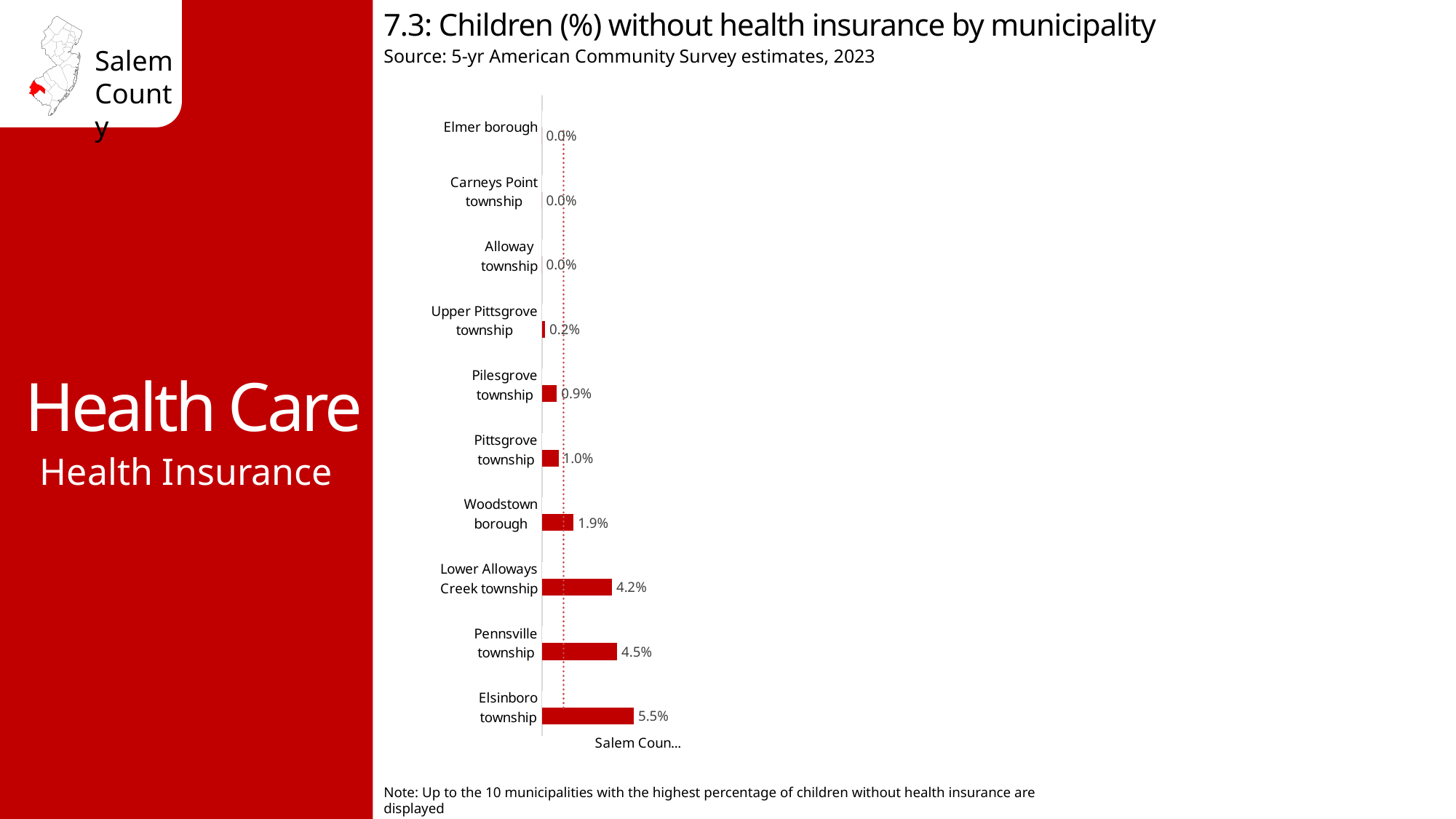
What is the difference between the values for Elsinboro township and Pennsville township? 1.0% What percentage of children are without health insurance in Elsinboro township? 5.5% What is the difference between the values for Lower Alloways Creek township and Woodstown borough? 2.3% Which municipality has the highest percentage of children without health insurance? Elsinboro township What kind of chart is shown on the slide? Bar chart How many municipalities are shown in the chart? 10 What is the value shown for Pennsville township? 4.5% How many municipalities show a value of 0.0%? 3 Which is larger, the value for Pittsgrove township or the value for Pilesgrove township? Pittsgrove township What is the value for Woodstown borough? 1.9% What is the value shown for Upper Pittsgrove township? 0.2% What percentage is shown for Lower Alloways Creek township? 4.2%